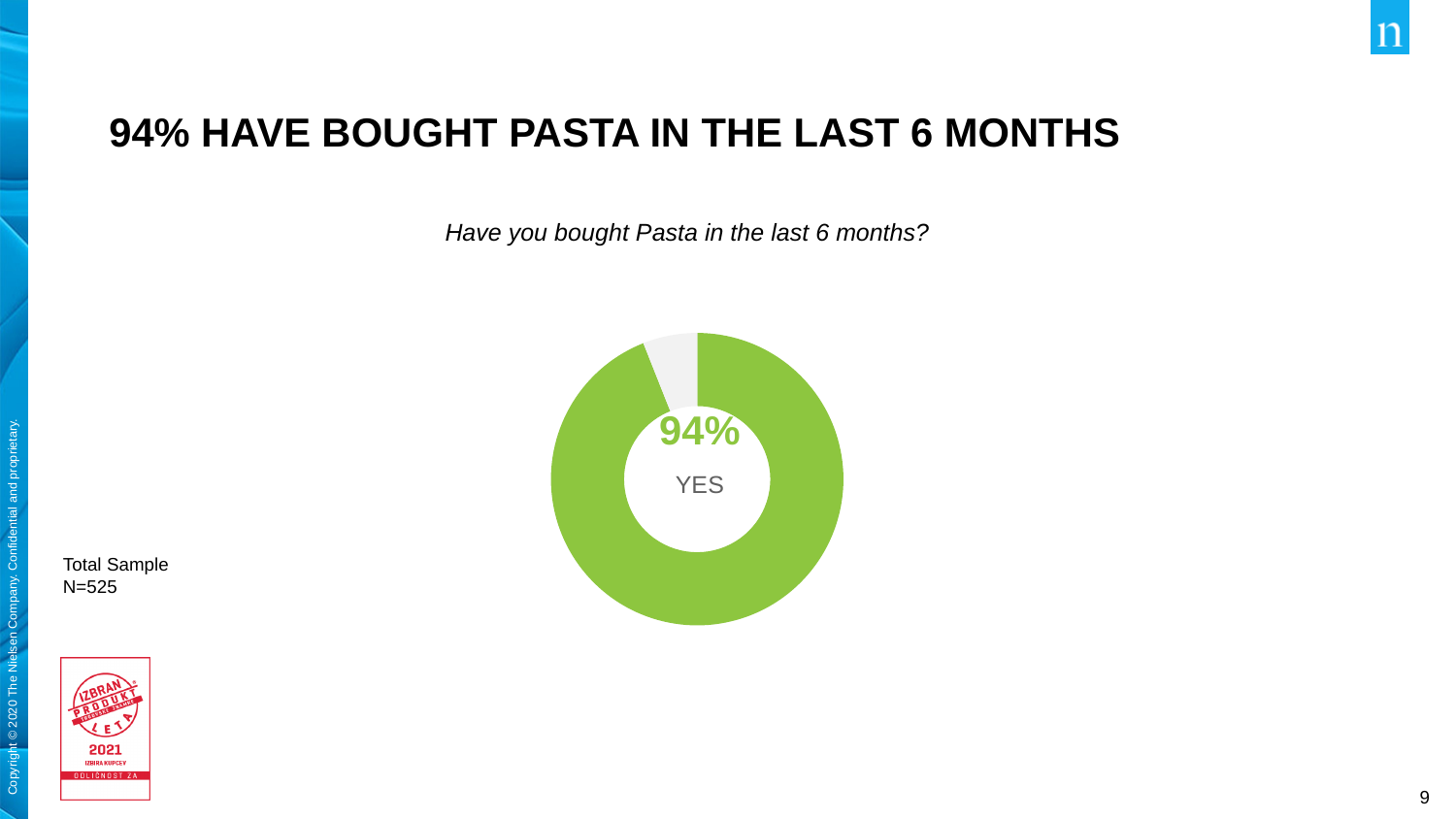
What kind of chart is shown on the slide? Pie chart (donut) What survey question is the chart based on? Have you bought Pasta in the last 6 months? Which slice of the chart is larger, the YES slice or the unlabeled slice? YES What percentage of respondents answered YES to having bought pasta in the last 6 months? 94% Is the value for YES greater or less than 50%? greater What share of the pie does the YES slice represent? 94% How many slices does the donut chart have? 2 Which response category is the largest in the chart? YES What is the sample size (N) shown for the chart? N=525